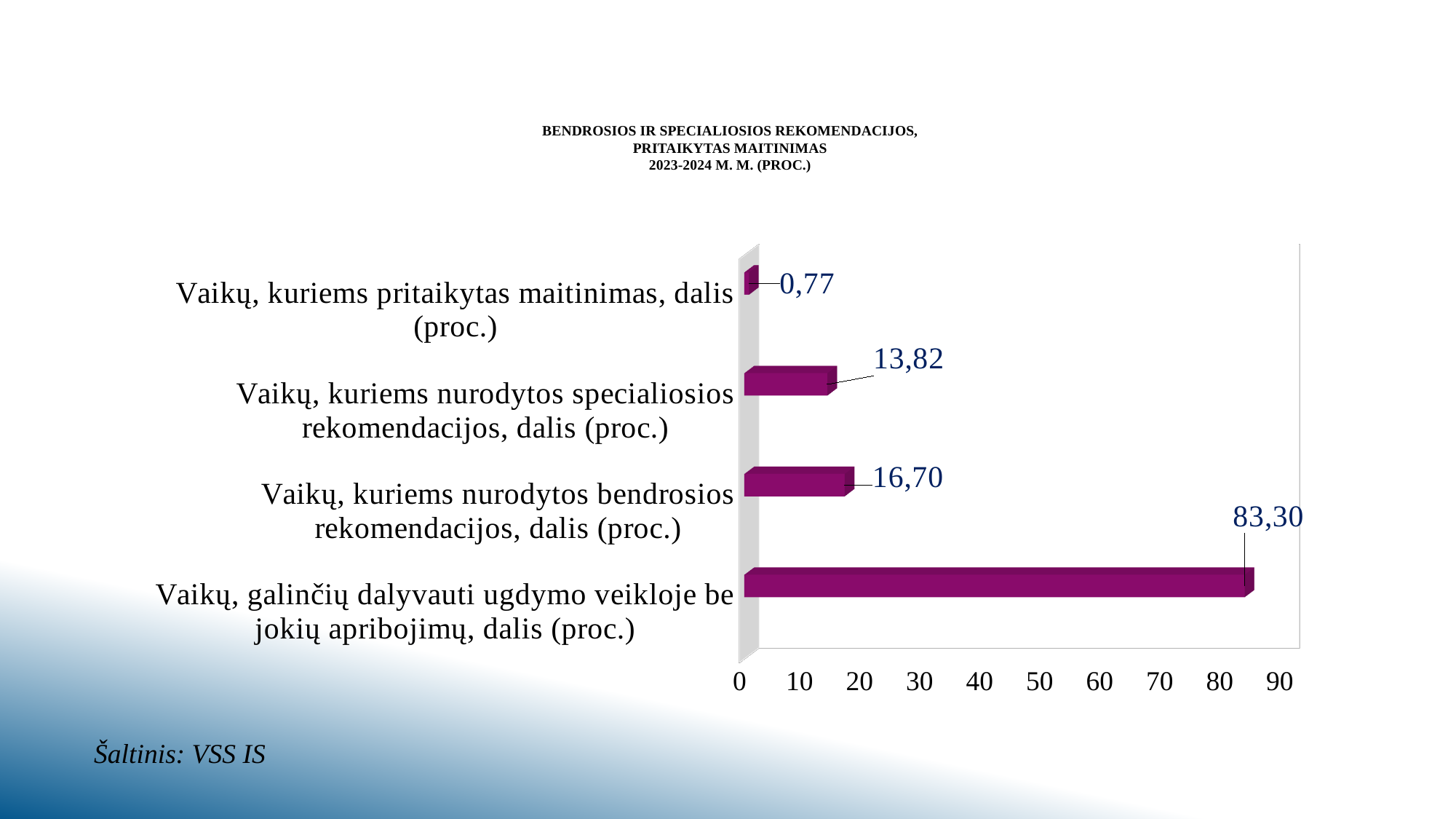
Which category has the highest value? Vaikų, galinčių dalyvauti ugdymo veikloje be jokių apribojimų, dalis (proc.) What kind of chart is shown on the slide? bar chart What is the value for 'Vaikų, kuriems nurodytos specialiosios rekomendacijos, dalis (proc.)'? 13,82 What source is cited below the chart? VSS IS What is the value for 'Vaikų, kuriems pritaikytas maitinimas, dalis (proc.)'? 0,77 Which is larger: the value for specialiosios rekomendacijos or the value for bendrosios rekomendacijos? Vaikų, kuriems nurodytos bendrosios rekomendacijos, dalis (proc.) Which category has the lowest value? Vaikų, kuriems pritaikytas maitinimas, dalis (proc.) Is the value for 'Vaikų, galinčių dalyvauti ugdymo veikloje be jokių apribojimų' greater or less than 80? greater What is the difference between the values for bendrosios rekomendacijos and specialiosios rekomendacijos? 2,88 How many categories are shown in the chart? 4 What is the value for 'Vaikų, kuriems nurodytos bendrosios rekomendacijos, dalis (proc.)'? 16,70 What is the value for 'Vaikų, galinčių dalyvauti ugdymo veikloje be jokių apribojimų, dalis (proc.)'? 83,30